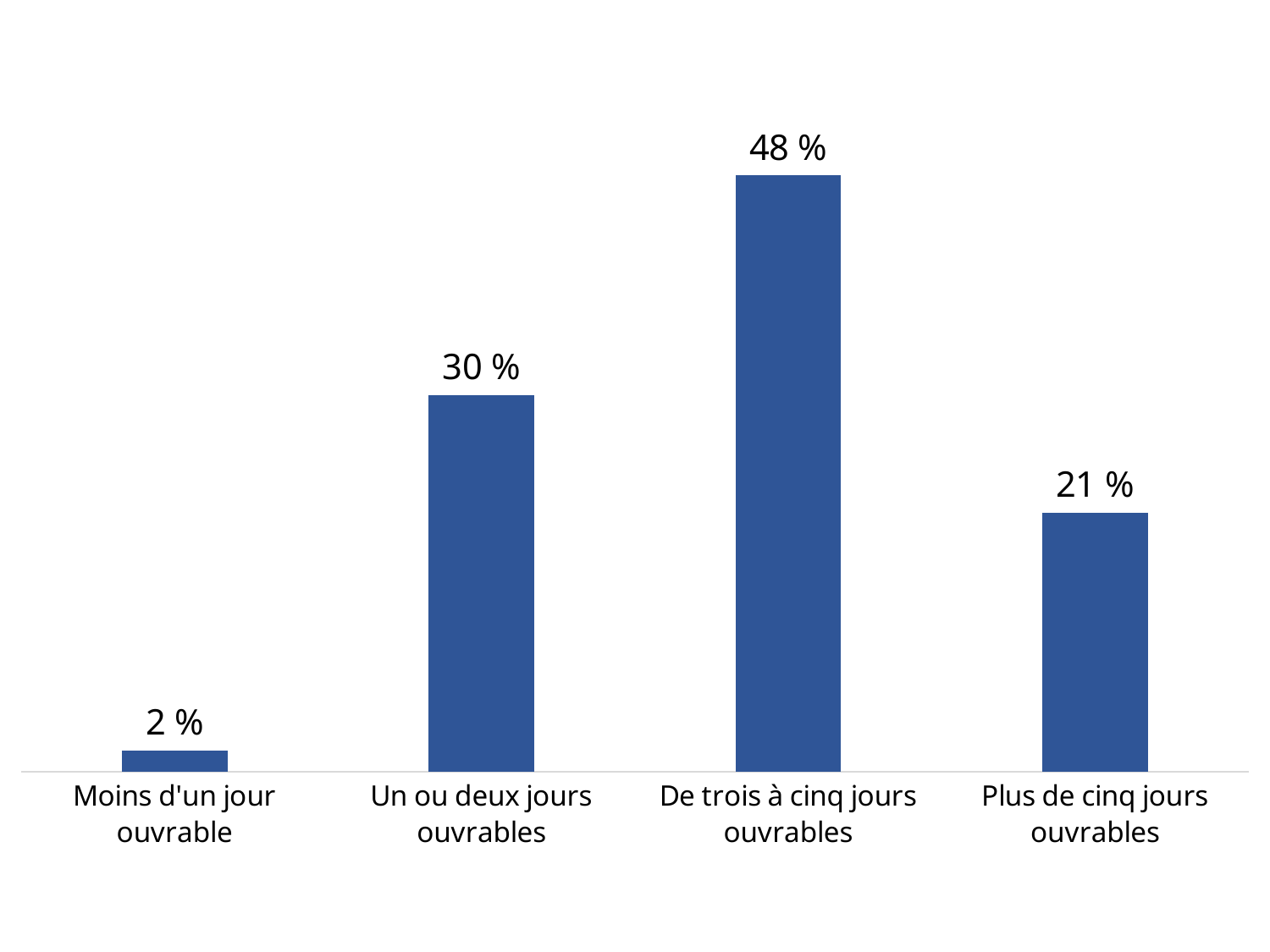
What is the value for "Plus de cinq jours ouvrables"? 21 % Which is larger, the value for "Un ou deux jours ouvrables" or the value for "Plus de cinq jours ouvrables"? Un ou deux jours ouvrables What kind of chart is shown on the slide? Bar chart What is the value for "De trois à cinq jours ouvrables"? 48 % Which category has the highest value? De trois à cinq jours ouvrables What colour are the bars in the chart? Blue What is the difference between the values for "De trois à cinq jours ouvrables" and "Un ou deux jours ouvrables"? 18 % How many categories are shown in the chart? 4 What is the value for "Moins d'un jour ouvrable"? 2 % Which category has the lowest value? Moins d'un jour ouvrable What is the difference between the values for "Un ou deux jours ouvrables" and "Plus de cinq jours ouvrables"? 9 % What is the value for "Un ou deux jours ouvrables"? 30 %